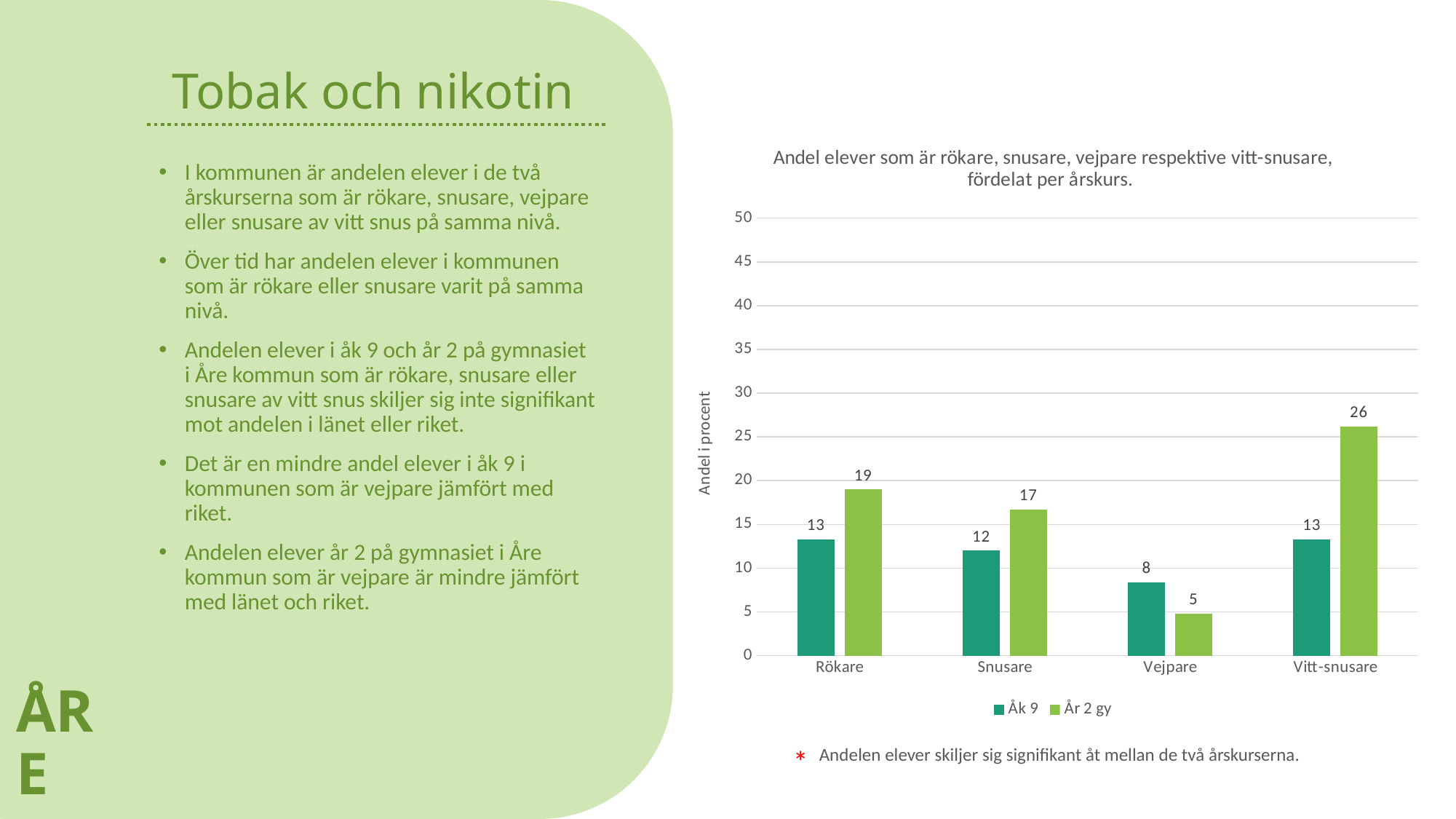
What is the label of the y axis? Andel i procent Is the value for År 2 gy in the Snusare category greater or less than 20? less What is the value for År 2 gy in the Vitt-snusare category? 26 How many categories are shown on the x axis? 4 Which category has the lowest value for Åk 9? Vejpare Which is larger in the Vejpare category, Åk 9 or År 2 gy? Åk 9 Which category has the highest value for År 2 gy? Vitt-snusare How many series does the legend list? 2 What is the value for År 2 gy in the Vejpare category? 5 What is the value for Åk 9 in the Rökare category? 13 What kind of chart is shown on the slide? bar chart What is the difference between the År 2 gy and Åk 9 values in the Vitt-snusare category? 13